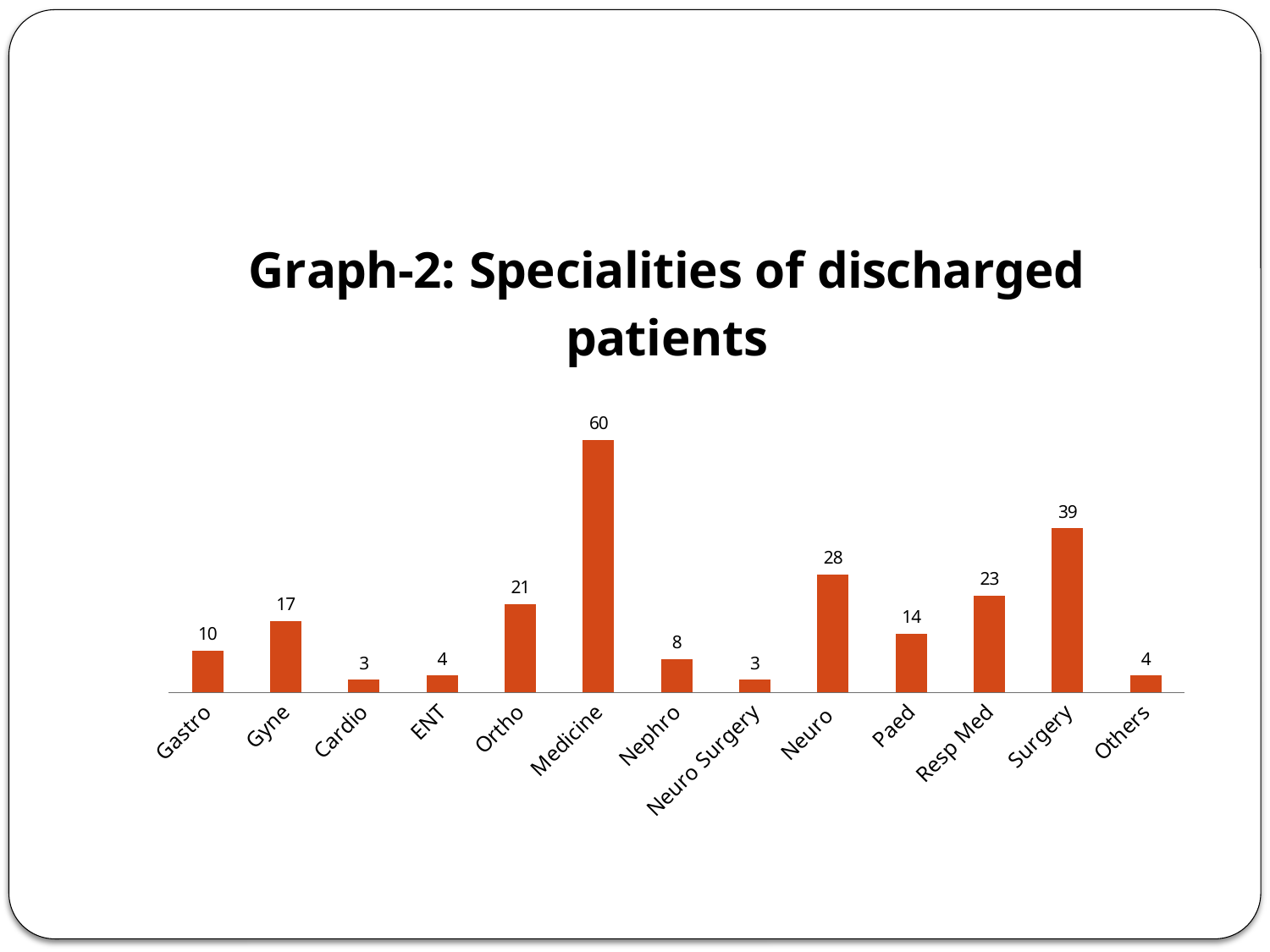
What is the value for Resp Med? 23 What kind of chart is shown on the slide? Bar chart How many specialities are shown on the chart? 13 What is the value for Neuro Surgery? 3 What is the value for Surgery? 39 Which is larger, the value for Gyne or the value for Ortho? Ortho Which speciality has the highest value? Medicine What is the difference between the values for Neuro and Paed? 14 What is the title of the chart? Graph-2: Specialities of discharged patients What is the value for Medicine? 60 What is the difference between the values for Medicine and Surgery? 21 Which is larger, the value for Nephro or the value for Gastro? Gastro